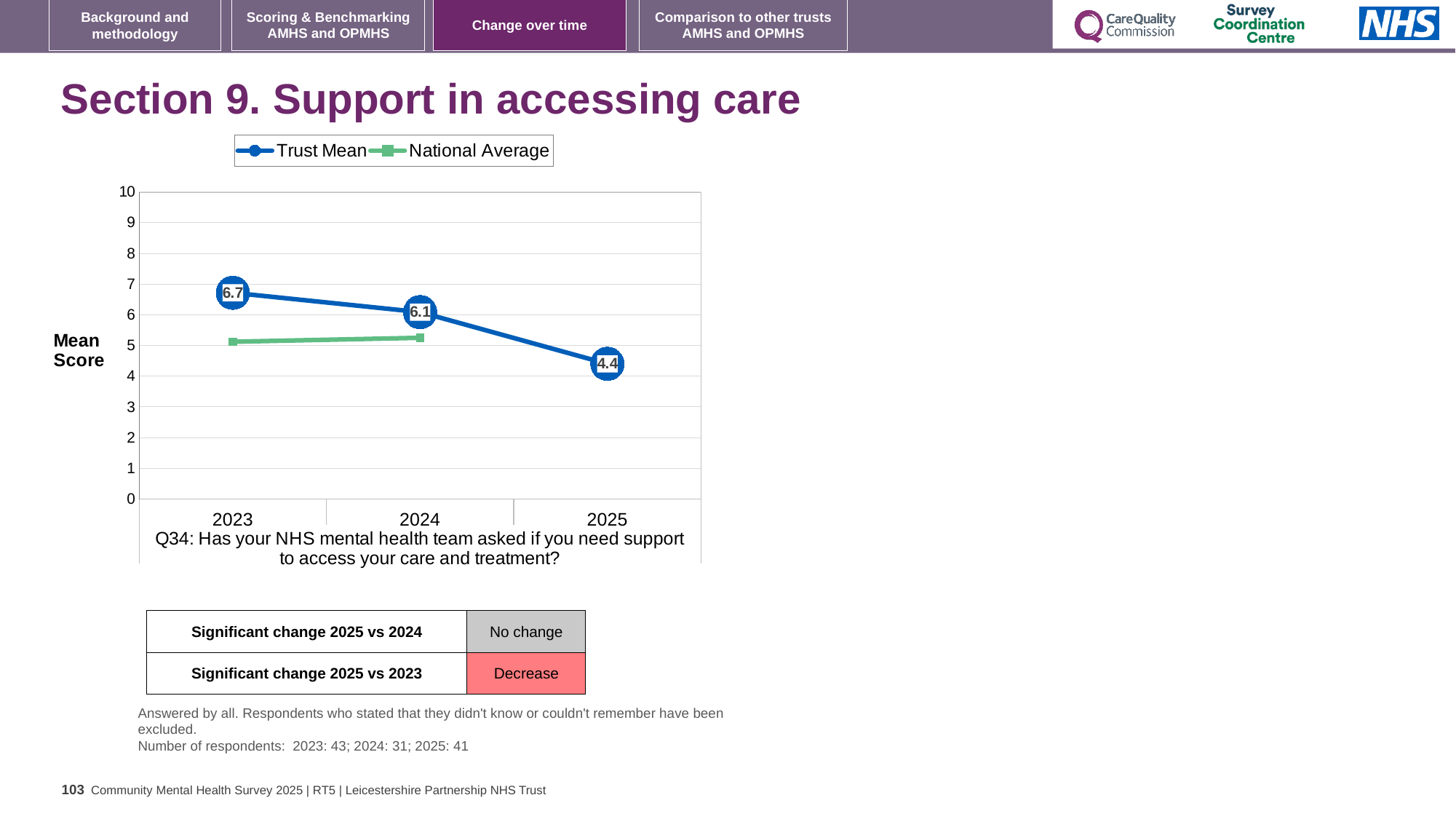
In which year is the Trust Mean score highest? 2023 Is the National Average value for 2023 greater or less than 6? less In which year is the Trust Mean score lowest? 2025 Is the National Average value for 2024 greater or less than 5? greater What is the Trust Mean score for 2024? 6.1 How many series does the legend list? 2 What kind of chart is shown on the slide? Line chart Does the Trust Mean score rise or fall from 2023 to 2025? Fall What is the Trust Mean score for 2023? 6.7 What is the Trust Mean score for 2025? 4.4 Which is larger, the Trust Mean score for 2024 or for 2025? 2024 What is the difference between the Trust Mean scores for 2023 and 2025? 2.3